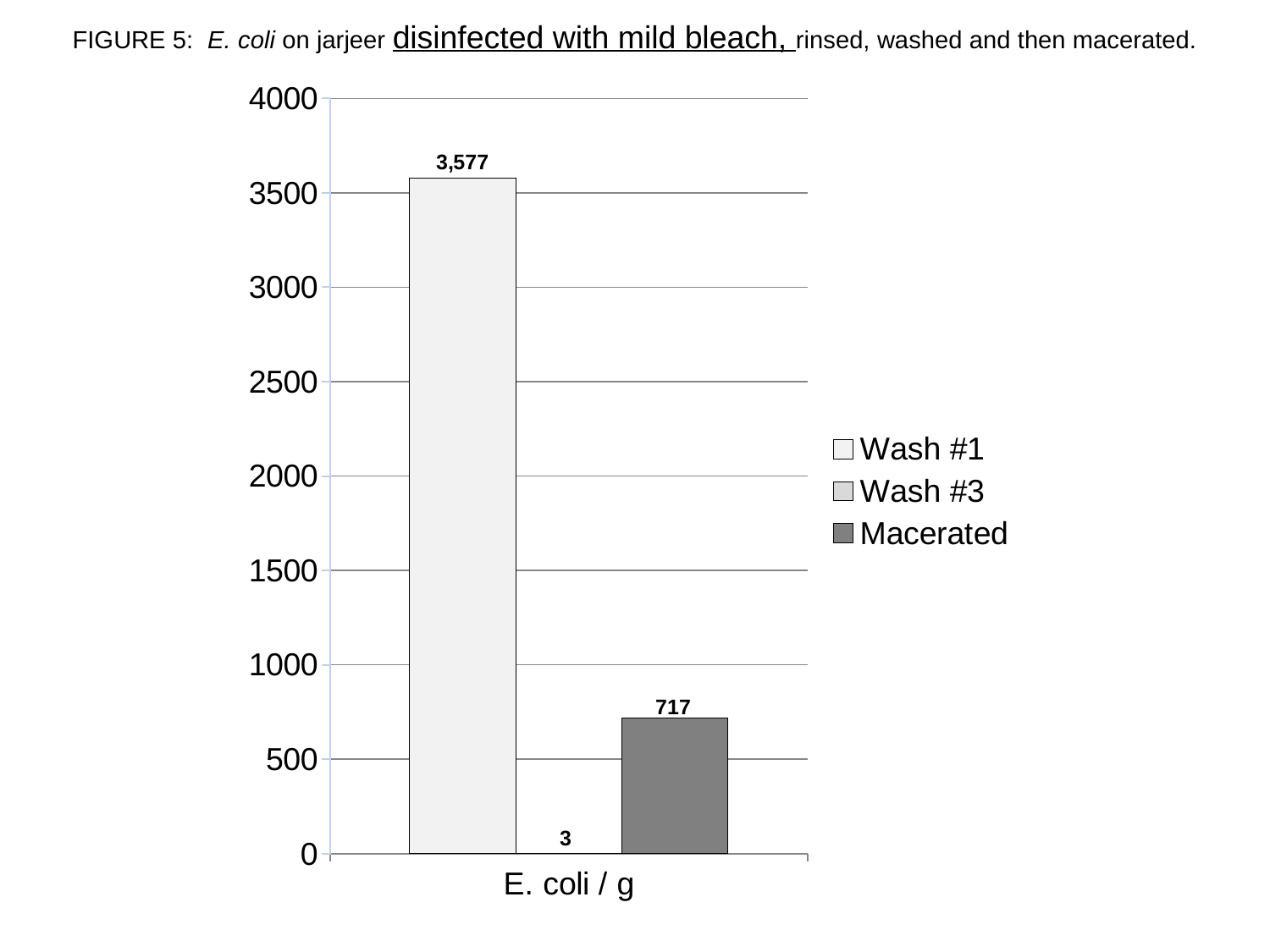
What kind of chart is shown on the slide? bar chart How many series does the legend list? 3 What is the E. coli / g value for Macerated? 717 Is the value for Macerated greater or less than 1000? less What is the label on the x axis of the chart? E. coli / g What is the E. coli / g value for Wash #1? 3,577 What is the E. coli / g value for Wash #3? 3 Which is larger, the Macerated value or the Wash #3 value? Macerated Which series has the highest E. coli / g value? Wash #1 Which series has the lowest E. coli / g value? Wash #3 What is the difference between the Macerated and Wash #3 values? 714 What is the difference between the Wash #1 and Macerated values? 2,860